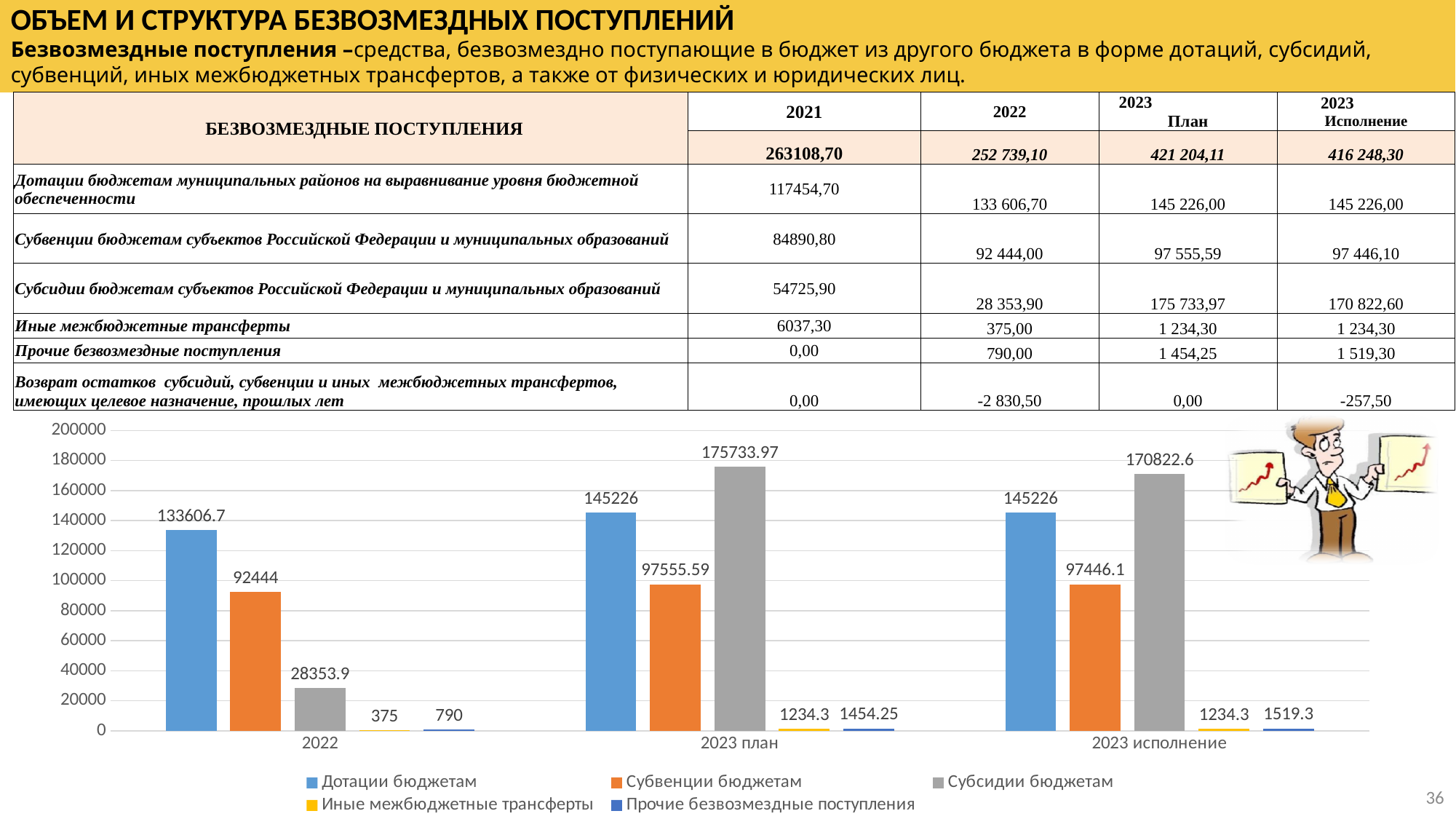
How many categories are shown on the x axis of the chart? 3 Is the value of Субсидии бюджетам for 2022 greater or less than 40000? less What is the value of Прочие безвозмездные поступления for 2023 исполнение in the chart? 1519.3 How many series does the chart legend list? 5 What is the value of Дотации бюджетам for 2022 in the chart? 133606.7 Which is larger: Субвенции бюджетам for 2023 план or for 2023 исполнение? 2023 план What is the difference between Субсидии бюджетам for 2023 план and for 2023 исполнение? 4911.37 What is the value of Субсидии бюджетам for 2023 план in the chart? 175733.97 Which series has the highest value in the 2022 category? Дотации бюджетам Which series has the lowest value in the 2022 category? Иные межбюджетные трансферты What type of chart is shown on the slide? bar chart What colour are the bars for Субсидии бюджетам in the chart? grey